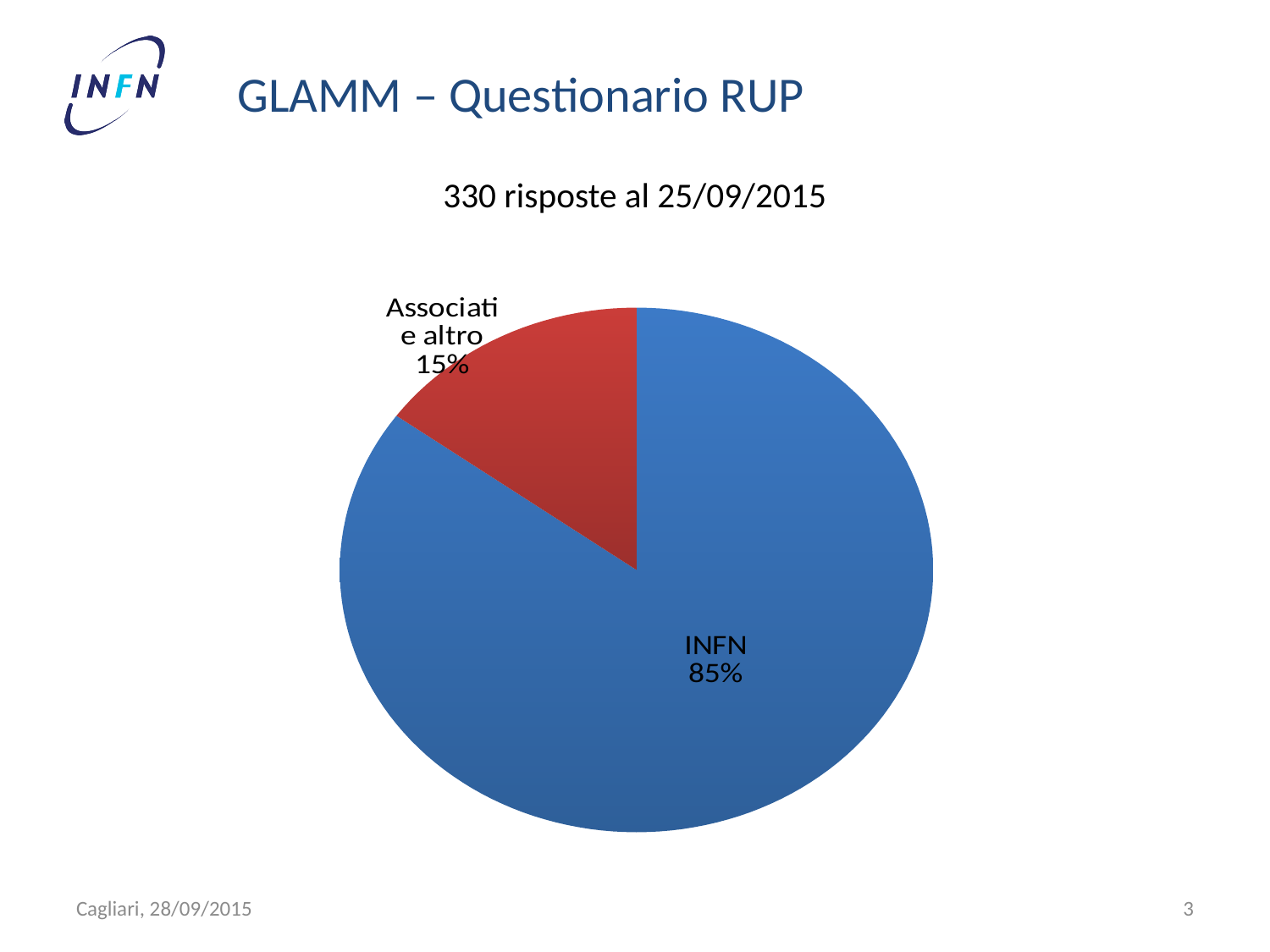
What share of the pie does 'Associati e altro' represent? 15% Which is larger, the INFN slice or the 'Associati e altro' slice? INFN How many responses does the text above the chart say were received by 25/09/2015? 330 What colour is the 'Associati e altro' slice of the pie? red What share of the pie does INFN represent? 85% What colour is the INFN slice of the pie? blue What kind of chart is shown on the slide? pie chart Which slice of the pie is the smallest? Associati e altro What is the difference in percentage points between the INFN slice and the 'Associati e altro' slice? 70 How many slices does the pie chart have? 2 Which slice of the pie is the largest? INFN